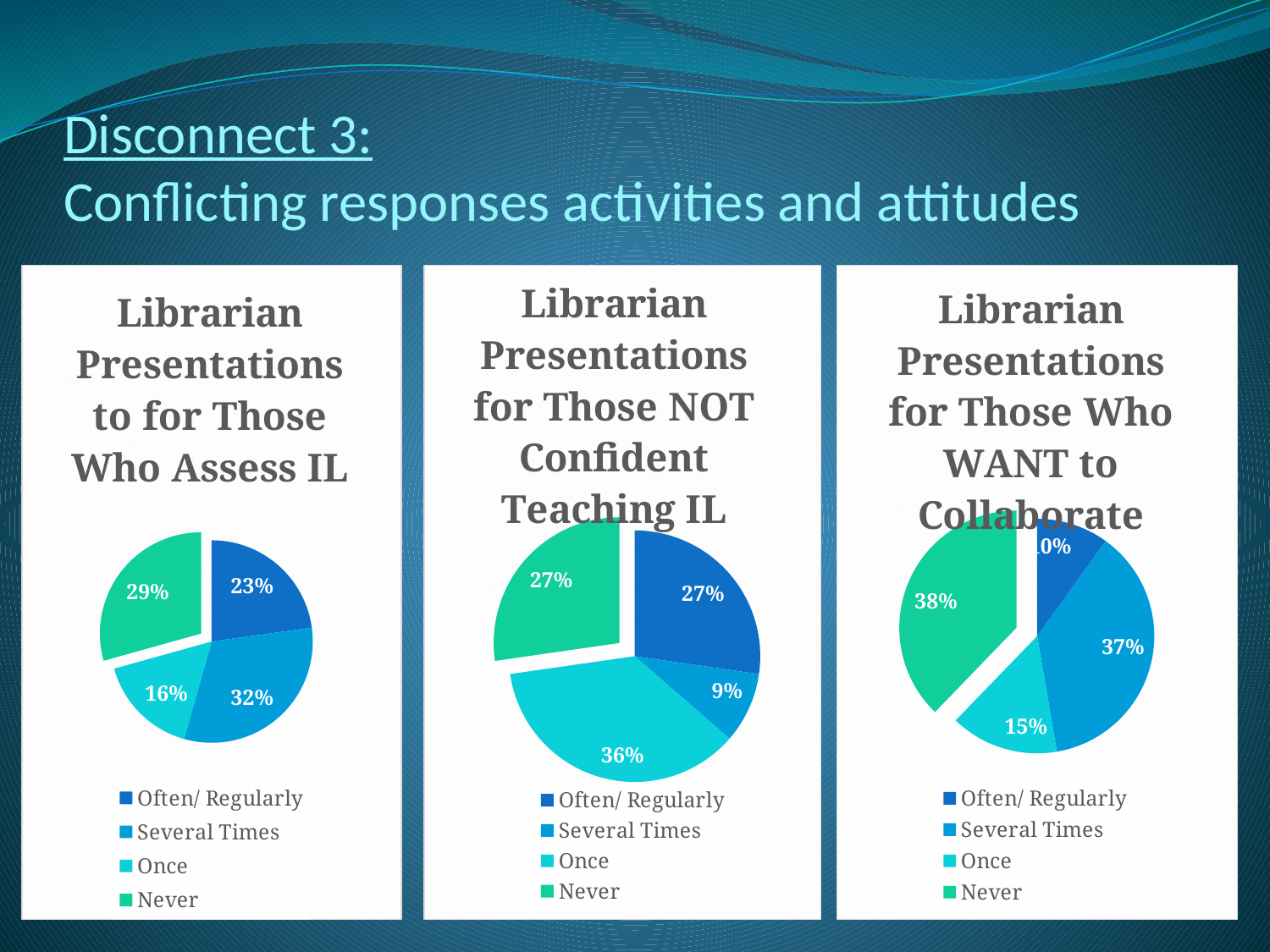
In the right chart, 'Librarian Presentations for Those Who WANT to Collaborate', what percentage is labelled for the Never slice? 38% In the right chart, 'Librarian Presentations for Those Who WANT to Collaborate', is the Several Times slice or the Once slice larger? Several Times In the middle chart, 'Librarian Presentations for Those NOT Confident Teaching IL', which category has the largest slice? Once In the left chart, 'Librarian Presentations to for Those Who Assess IL', which category has the smallest slice? Once In the middle chart, 'Librarian Presentations for Those NOT Confident Teaching IL', which category has the smallest slice? Several Times In the middle chart, 'Librarian Presentations for Those NOT Confident Teaching IL', what percentage is labelled for the Once slice? 36% How many categories does the legend of the left chart, 'Librarian Presentations to for Those Who Assess IL', list? 4 In the left chart, 'Librarian Presentations to for Those Who Assess IL', what is the difference between the Several Times and Often/Regularly percentages? 9% In the left chart, 'Librarian Presentations to for Those Who Assess IL', what percentage is labelled for the Never slice? 29% In the left chart, 'Librarian Presentations to for Those Who Assess IL', what percentage is labelled for the Several Times slice? 32% What type of chart is used for the three charts on the slide? Pie chart In the middle chart, 'Librarian Presentations for Those NOT Confident Teaching IL', what is the difference between the Once and Several Times percentages? 27%